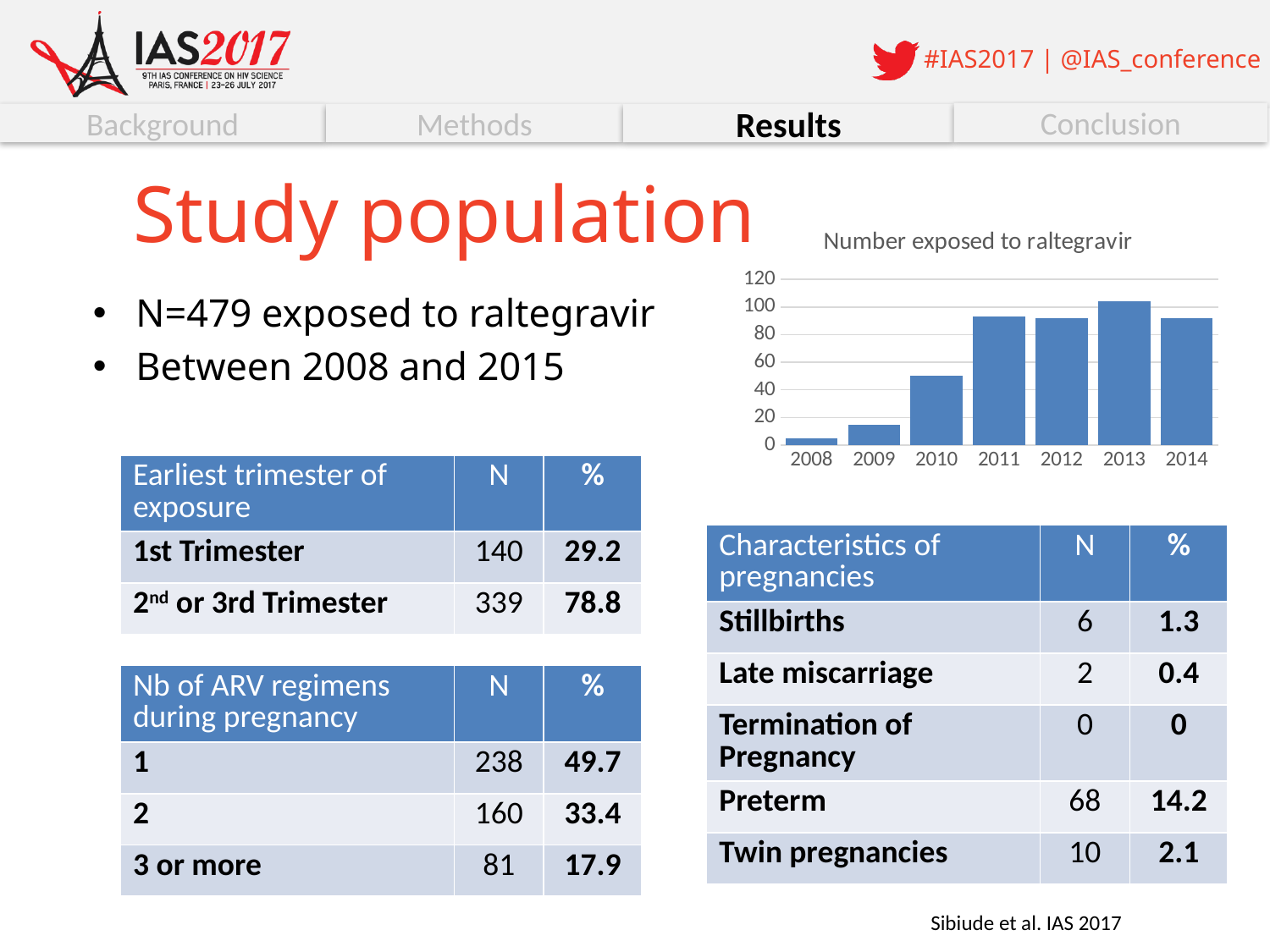
How many years are shown on the x axis of the chart? 7 Is the value for 2011 greater or less than 80? greater Is the value for 2013 greater or less than 100? greater Do the values generally rise or fall from 2008 to 2013? rise What is the title of the chart on the slide? Number exposed to raltegravir Is the value for 2010 greater or less than 40? greater Which year has the highest number exposed to raltegravir? 2013 What kind of chart is shown on the slide? bar chart Which year has a larger value, 2013 or 2014? 2013 Which year has a larger value, 2010 or 2011? 2011 Which year has the lowest number exposed to raltegravir? 2008